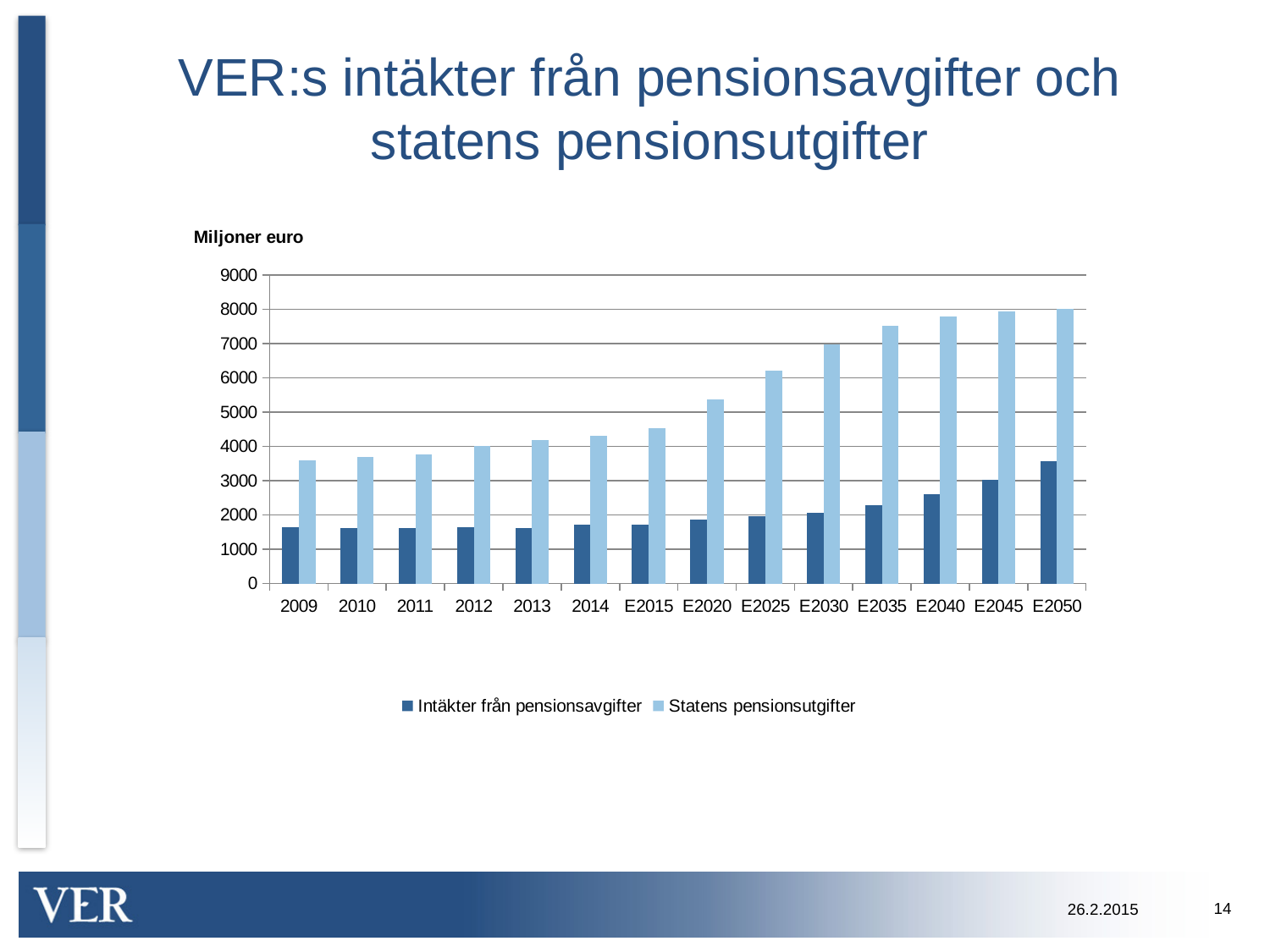
Is the value for Intäkter från pensionsavgifter in 2009 greater or less than 2000? less Is the value for Intäkter från pensionsavgifter in E2050 greater or less than 3000? greater Do the values for Statens pensionsutgifter rise or fall from 2009 to E2050? rise Is the value for Statens pensionsutgifter in E2030 greater or less than 6000? greater What kind of chart is shown on the slide? bar chart What unit is stated above the chart? Miljoner euro How many series does the legend list? 2 Which category has the highest value for Intäkter från pensionsavgifter? E2050 Which category has the lowest value for Statens pensionsutgifter? 2009 Which is larger in 2009: Intäkter från pensionsavgifter or Statens pensionsutgifter? Statens pensionsutgifter How many categories are shown on the x axis? 14